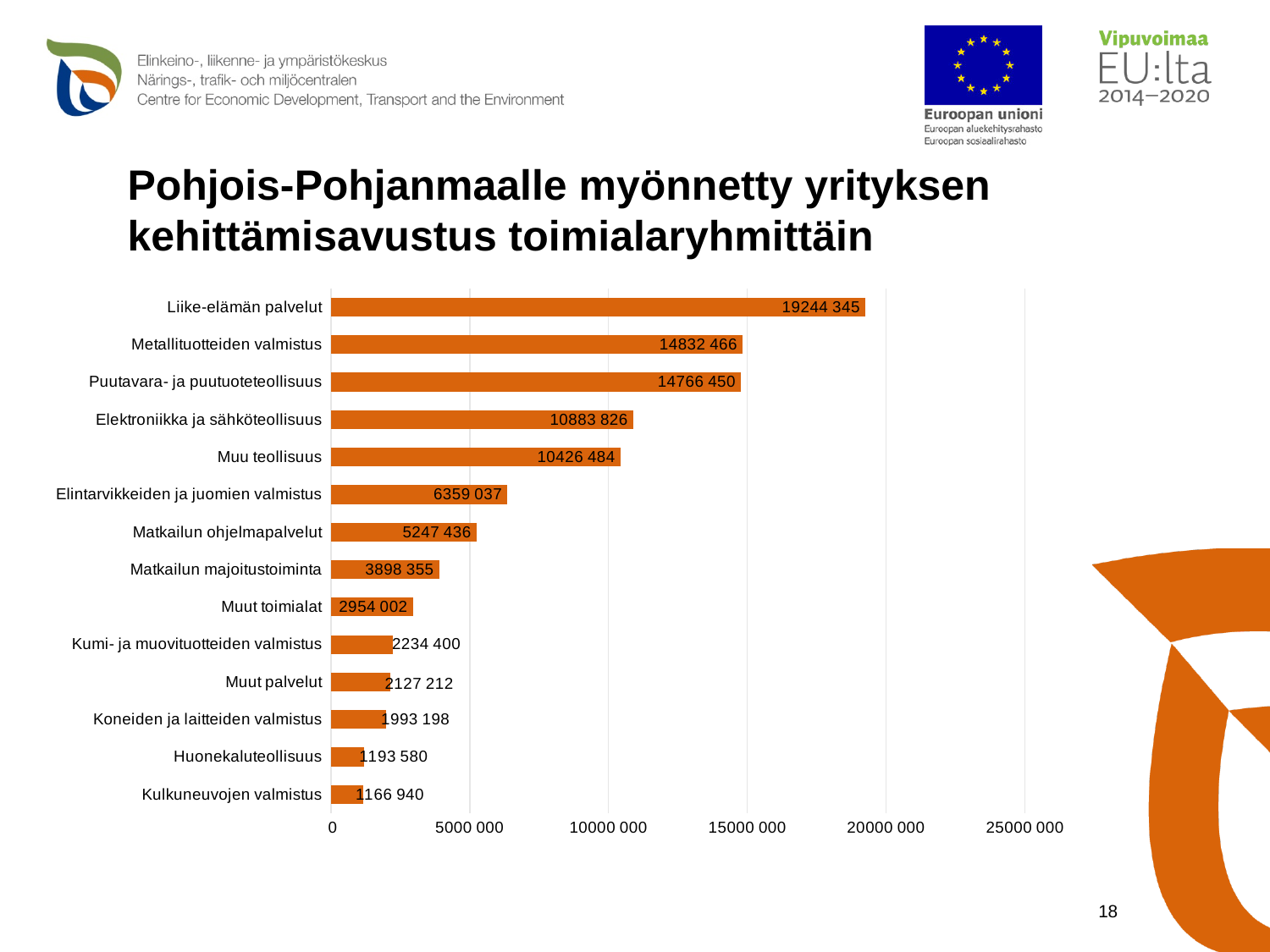
How many categories are shown in the chart? 14 Is the value for Elintarvikkeiden ja juomien valmistus greater or less than 5000 000? greater What kind of chart is shown on the slide? bar chart Which category has the highest value? Liike-elämän palvelut What is the difference between the values for Liike-elämän palvelut and Metallituotteiden valmistus? 4411 879 Which is larger, the value for Matkailun ohjelmapalvelut or the value for Muut toimialat? Matkailun ohjelmapalvelut What is the value for Matkailun majoitustoiminta? 3898 355 What is the value for Koneiden ja laitteiden valmistus? 1993 198 What is the difference between the values for Elektroniikka ja sähköteollisuus and Muu teollisuus? 457 342 What colour are the bars in the chart? orange What is the value for Liike-elämän palvelut? 19244 345 Which category has the lowest value? Kulkuneuvojen valmistus